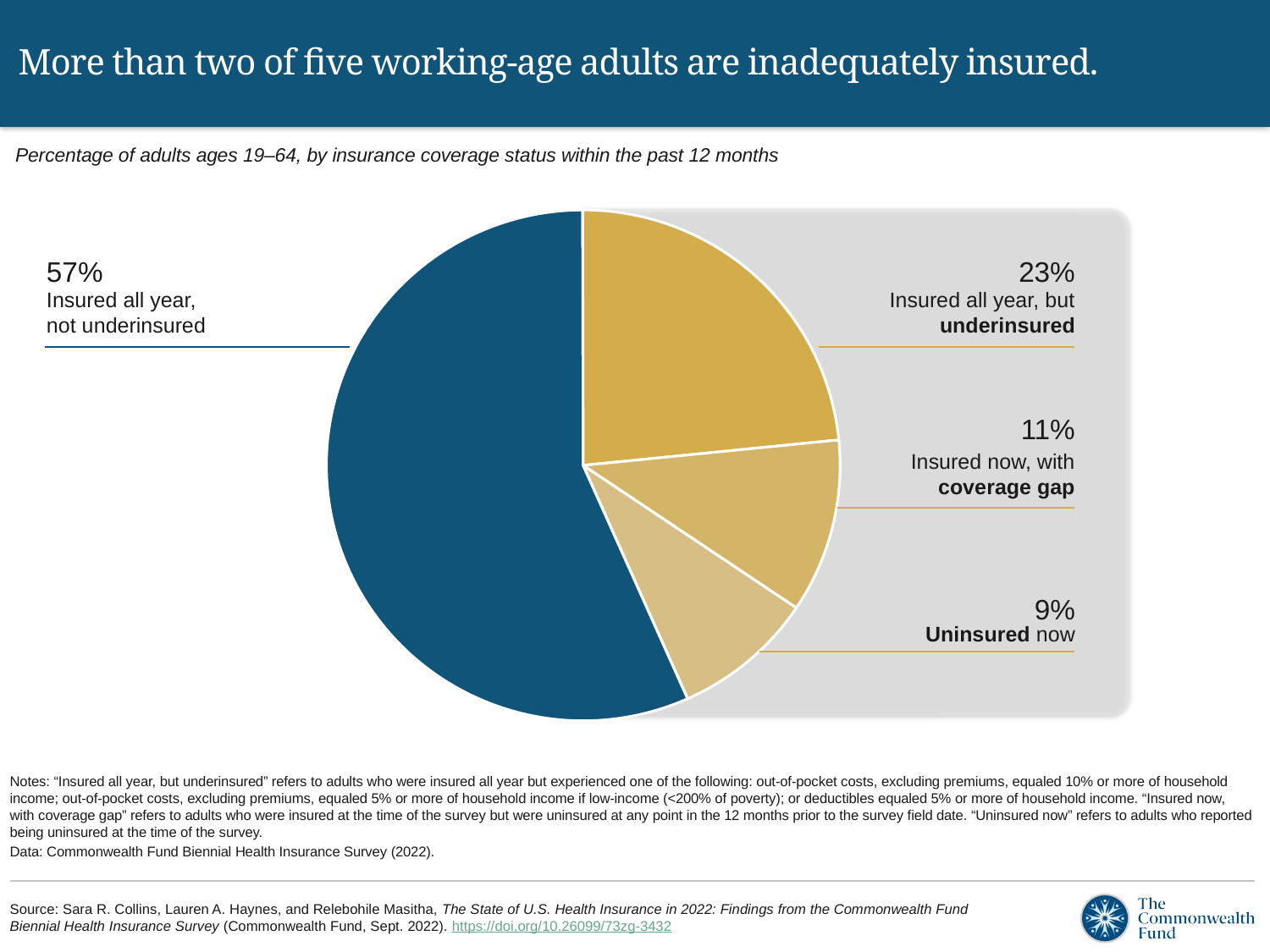
What is the title of the slide? More than two of five working-age adults are inadequately insured. What percentage of adults were uninsured now? 9% What is the difference in percentage points between adults insured all year, not underinsured and adults insured all year, but underinsured? 34 What percentage of adults were insured now, with a coverage gap? 11% What kind of chart is shown on the slide? Pie chart What percentage of adults were insured all year, but underinsured? 23% How many insurance coverage status categories are shown in the pie chart? 4 Which insurance coverage status has the largest share of the pie? Insured all year, not underinsured Which insurance coverage status has the smallest share of the pie? Uninsured now Which is larger: the share insured now with a coverage gap or the share uninsured now? Insured now, with coverage gap What is the combined percentage of adults who were underinsured, had a coverage gap, or were uninsured now? 43% What percentage of adults ages 19–64 were insured all year, not underinsured? 57%